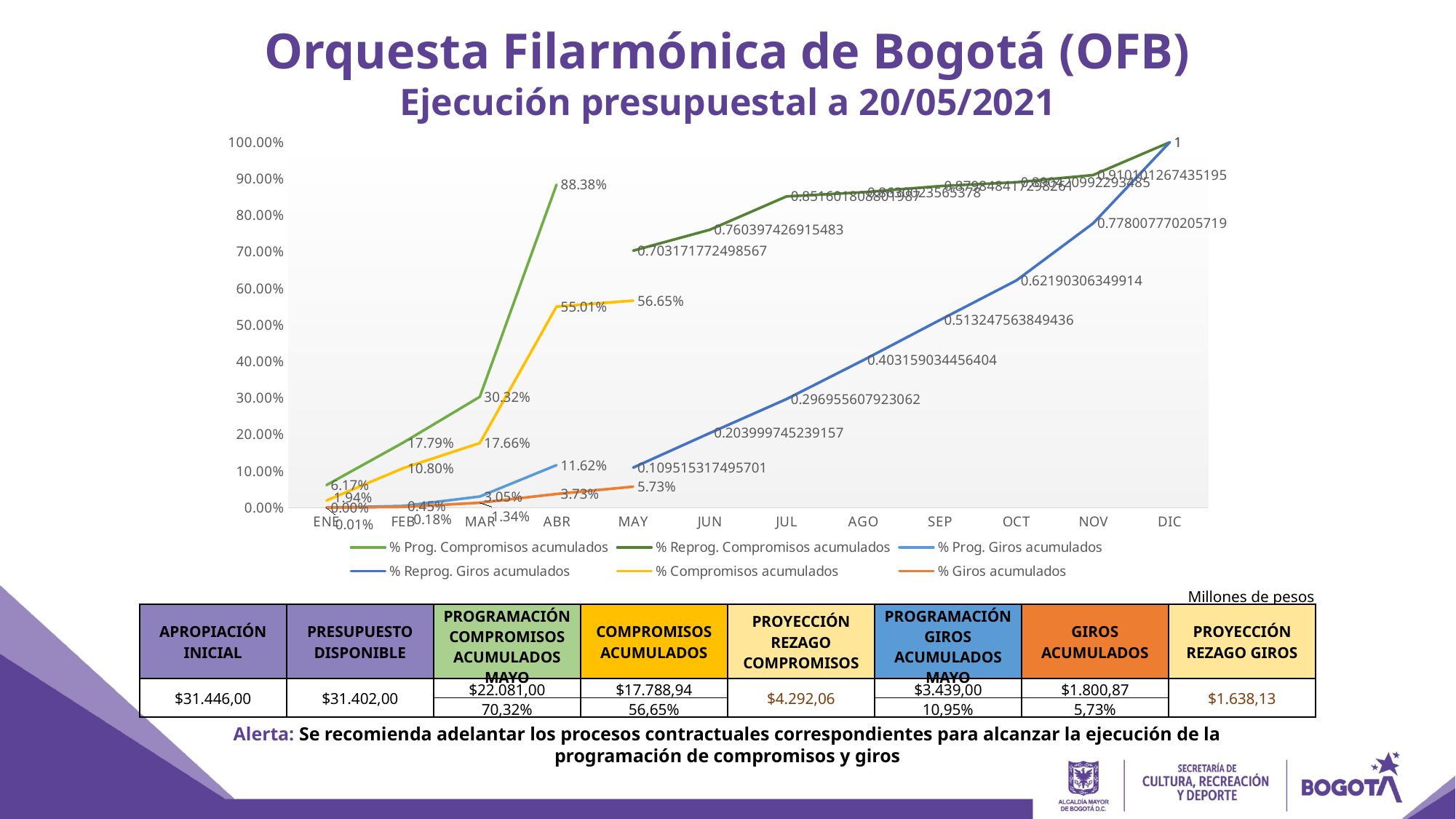
How many series does the chart legend list? 6 What is the value of % Prog. Giros acumulados in ABR? 11.62% What is the value of % Compromisos acumulados in MAY? 56.65% What is the value of % Giros acumulados in MAY? 5.73% Does the % Reprog. Giros acumulados series rise or fall from MAY to DIC? rise What is the difference between % Prog. Compromisos acumulados and % Compromisos acumulados in ABR? 33.37% In MAR, which is larger: % Prog. Compromisos acumulados or % Compromisos acumulados? % Prog. Compromisos acumulados Is the value of % Reprog. Giros acumulados in NOV greater or less than 70.00%? greater What kind of chart is shown on the slide? line chart How many months are shown on the x axis of the chart? 12 What is the difference between % Compromisos acumulados and % Giros acumulados in MAY? 50.92% What is the value of % Prog. Compromisos acumulados in ABR? 88.38%